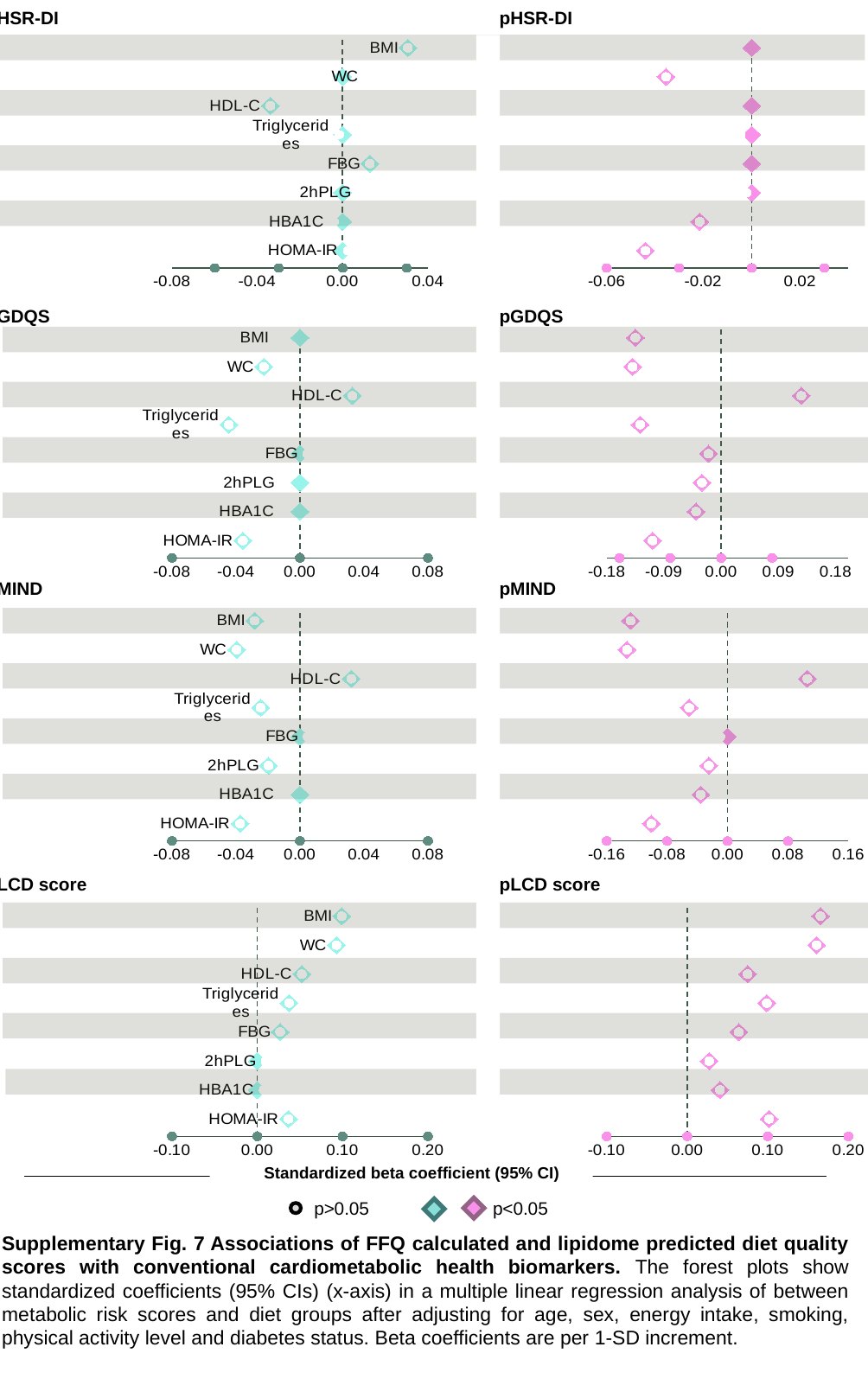
What kind of chart is used in each of the eight panels on the slide? Forest plot (dot plot with confidence intervals) In the pGDQS panel, which biomarker has the highest standardized beta coefficient? HDL-C According to the legend, what does a filled diamond marker indicate? p<0.05 How many biomarker categories are plotted in the HSR-DI panel? 8 In the pLCD score panel, is the value for BMI greater or less than 0.10? greater In the pLCD score panel, which has the larger standardized beta coefficient, BMI or HDL-C? BMI In the pMIND panel, is the value for BMI greater or less than -0.08? less In the GDQS panel, is the value for Triglycerides greater or less than 0.00? less In the HSR-DI panel, which biomarker has the highest standardized beta coefficient? BMI How many entries does the legend at the bottom of the slide list? 2 In the HSR-DI panel, which biomarker has the lowest standardized beta coefficient? HDL-C